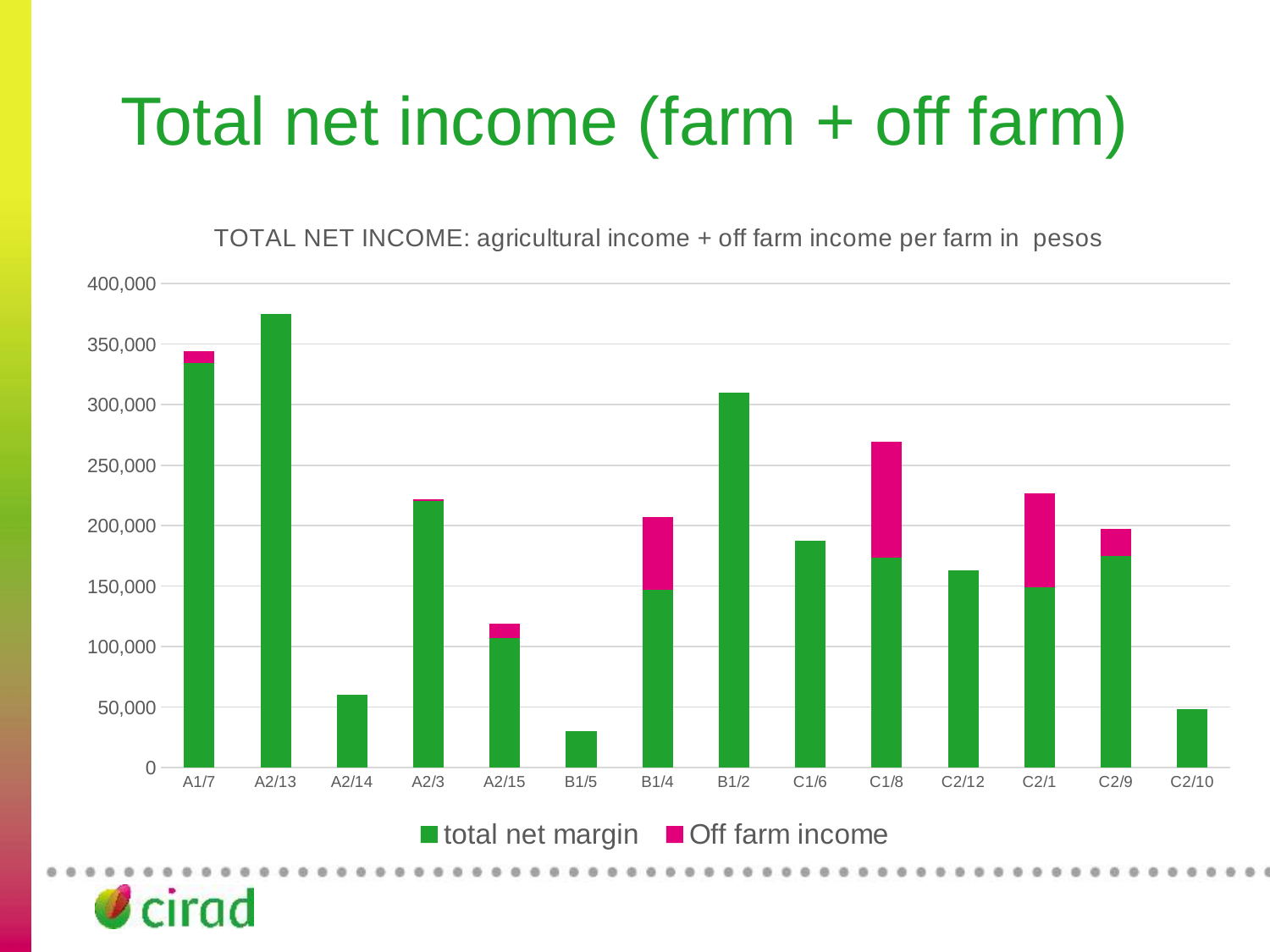
Which has the taller total bar, B1/2 or C1/6? B1/2 Is the total bar for C1/6 greater or less than 200,000? less Is the total bar for A2/13 greater or less than 350,000? greater How many farms (categories) are shown on the x axis of the chart? 14 Which farm has the highest total net income bar? A2/13 Which farm has the lowest total net income bar? B1/5 How many series does the chart's legend list? 2 Which farm has the largest Off farm income segment? C1/8 What kind of chart is shown on the slide? Stacked bar chart What are the two series named in the chart's legend? total net margin; Off farm income Is the total bar for B1/5 greater or less than 50,000? less Which has the taller total bar, A2/14 or C2/10? A2/14